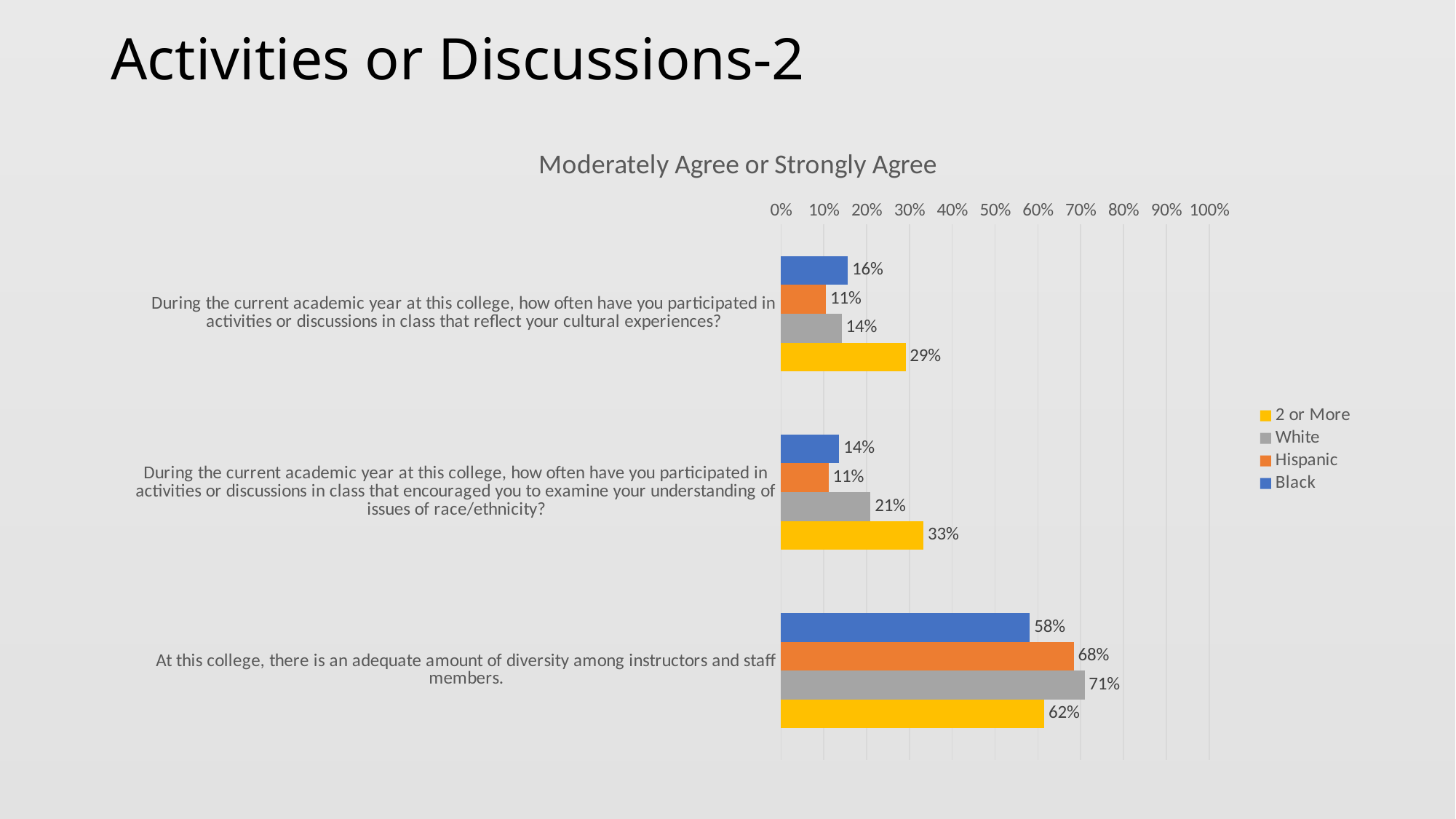
What kind of chart is shown on the slide? Bar chart How many survey items (categories) are shown on the chart? 3 What is the value for White on the question about activities or discussions that encouraged you to examine your understanding of issues of race/ethnicity? 21% What is the title of the chart? Moderately Agree or Strongly Agree Which group has the lowest value on the question about activities or discussions that reflect your cultural experiences? Hispanic How many series does the legend list? 4 What is the value for Black on the statement about adequate diversity among instructors and staff members? 58% Which is larger on the statement about adequate diversity among instructors and staff members: the value for 2 or More or the value for Black? 2 or More What is the value for 2 or More on the question about activities or discussions that reflect your cultural experiences? 29% What is the difference between the 2 or More and Black values on the question about examining your understanding of issues of race/ethnicity? 19% Which group has the highest value on the statement about adequate diversity among instructors and staff members? White What is the value for Hispanic on the statement about adequate diversity among instructors and staff members? 68%